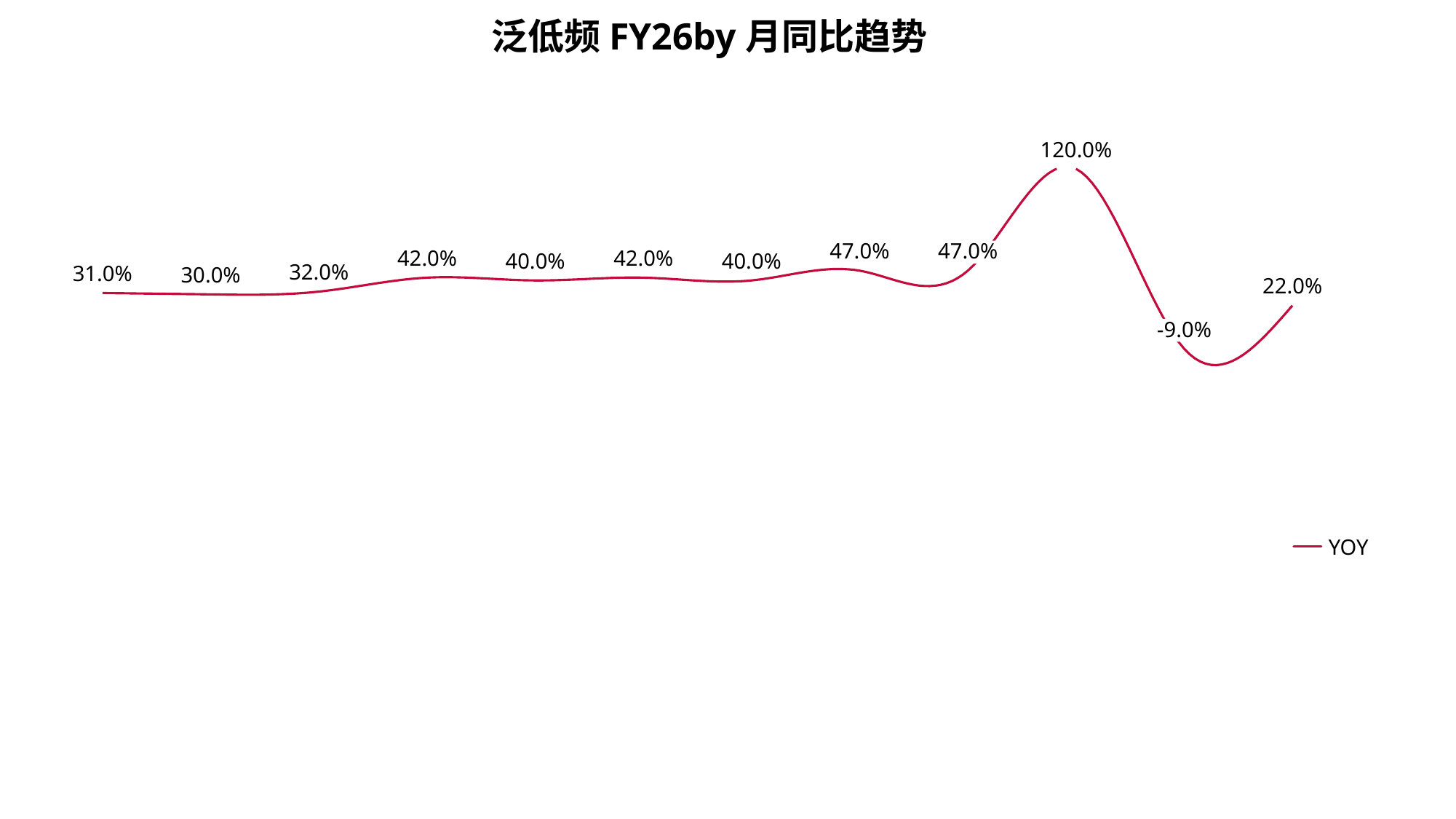
What series name is shown in the legend? YOY What is the value of the second data point on the line? 30.0% What is the highest value plotted on the line? 120.0% How many data points are plotted on the line? 12 What is the value of the first data point on the line? 31.0% What is the difference between the highest value (120.0%) and the lowest value (-9.0%) on the line? 129.0 percentage points What is the value of the last data point on the line? 22.0% What is the title of the chart? 泛低频 FY26by 月同比趋势 What is the lowest value plotted on the line? -9.0% How many series does the legend list? 1 Which is larger, the first data point (31.0%) or the last data point (22.0%)? the first data point (31.0%) What kind of chart is shown on the slide? line chart